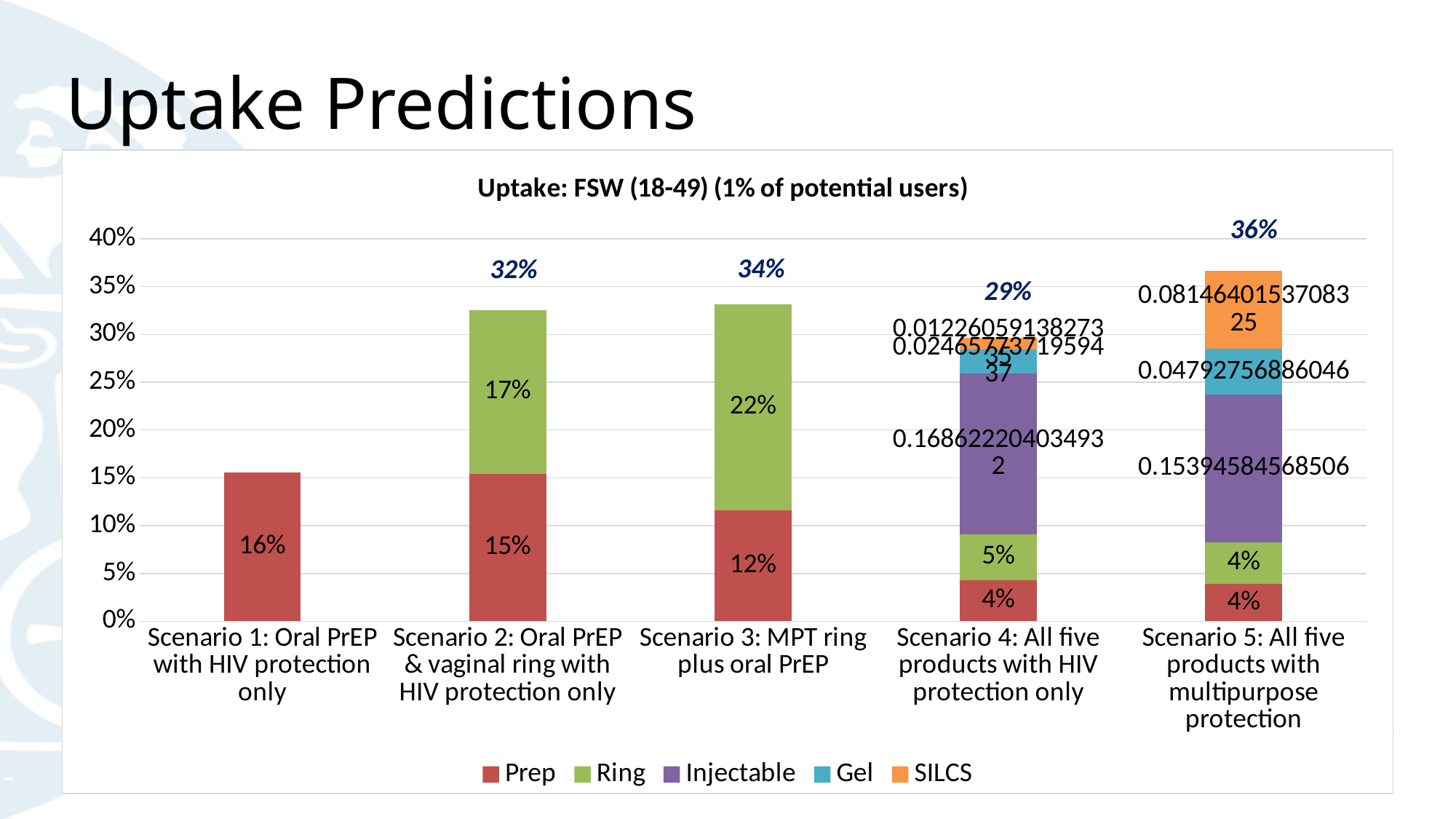
What is the title of the chart? Uptake: FSW (18-49) (1% of potential users) Which scenario has the lowest total uptake? Scenario 1: Oral PrEP with HIV protection only What is the Prep value for Scenario 1: Oral PrEP with HIV protection only? 16% Which scenario has the highest total uptake? Scenario 5: All five products with multipurpose protection What is the total uptake shown above the bar for Scenario 5: All five products with multipurpose protection? 36% What is the Ring value for Scenario 3: MPT ring plus oral PrEP? 22% What kind of chart is shown on the slide? Stacked bar chart How much larger is the Ring value in Scenario 3 than in Scenario 2? 5 percentage points What is the Ring value for Scenario 2: Oral PrEP & vaginal ring with HIV protection only? 17% Which has the larger Prep value, Scenario 2 or Scenario 3? Scenario 2 How many scenarios are plotted along the x axis? 5 How many series does the legend list? 5